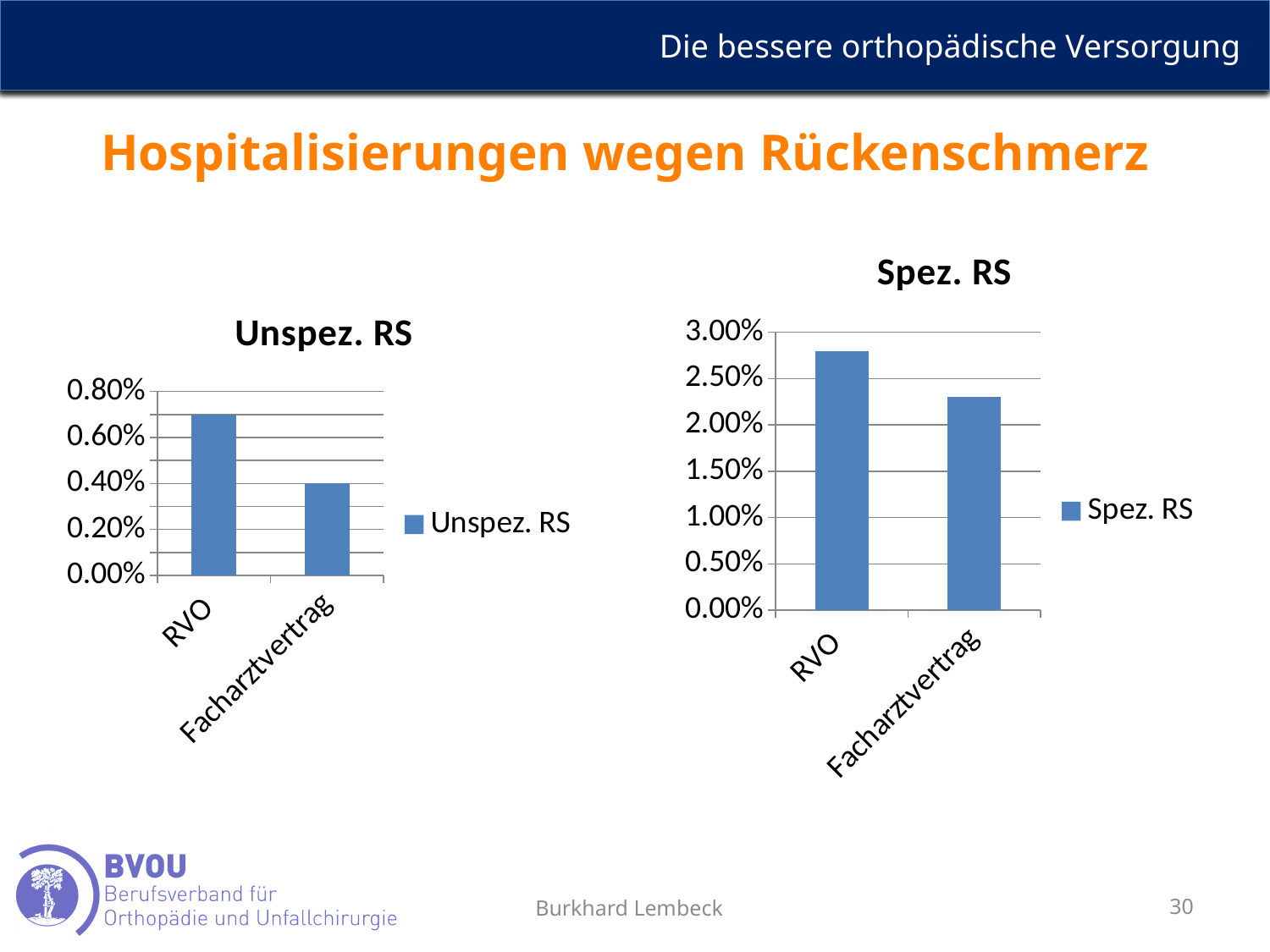
What kind of chart is the 'Spez. RS' chart? Bar chart In the 'Spez. RS' chart, which category has the highest value? RVO In the 'Spez. RS' chart, is the value for Facharztvertrag greater or less than 2.50%? less In the 'Unspez. RS' chart, is the value for Facharztvertrag greater or less than 0.60%? less In the 'Spez. RS' chart, is the value for Facharztvertrag greater or less than 2.00%? greater How many categories are shown in the 'Unspez. RS' chart? 2 In the 'Spez. RS' chart, which category has the lowest value? Facharztvertrag In the 'Spez. RS' chart, which is larger, the value for RVO or the value for Facharztvertrag? RVO In the 'Unspez. RS' chart, which category has the lowest value? Facharztvertrag In the 'Unspez. RS' chart, which category has the highest value? RVO